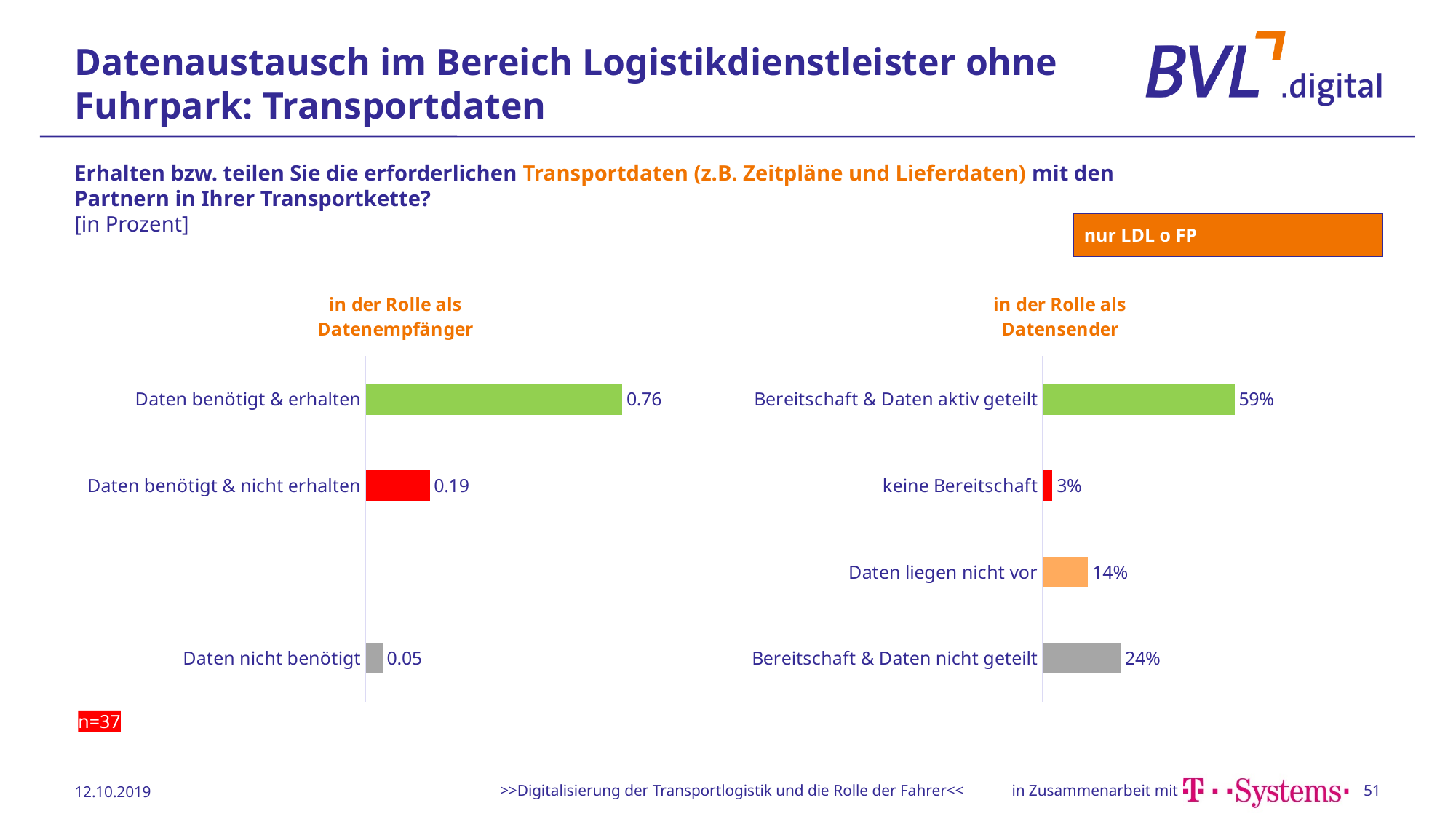
How many categories are shown in the 'in der Rolle als Datensender' chart? 4 In the 'in der Rolle als Datensender' chart, which category has the lowest value? keine Bereitschaft In the 'in der Rolle als Datensender' chart, what is the value for 'Daten liegen nicht vor'? 14% In the 'in der Rolle als Datenempfänger' chart, which category has the lowest value? Daten nicht benötigt In the 'in der Rolle als Datensender' chart, which is larger: 'Daten liegen nicht vor' or 'Bereitschaft & Daten nicht geteilt'? Bereitschaft & Daten nicht geteilt In the 'in der Rolle als Datenempfänger' chart, what is the value for 'Daten benötigt & erhalten'? 0.76 What type of chart is the 'in der Rolle als Datensender' chart? Bar chart In the 'in der Rolle als Datenempfänger' chart, what is the value for 'Daten benötigt & nicht erhalten'? 0.19 In the 'in der Rolle als Datensender' chart, what is the value for 'Bereitschaft & Daten aktiv geteilt'? 59% In the 'in der Rolle als Datenempfänger' chart, what is the difference between 'Daten benötigt & erhalten' and 'Daten benötigt & nicht erhalten'? 0.57 In the 'in der Rolle als Datensender' chart, what is the difference between 'Bereitschaft & Daten nicht geteilt' and 'keine Bereitschaft'? 21% How many categories are shown in the 'in der Rolle als Datenempfänger' chart? 3